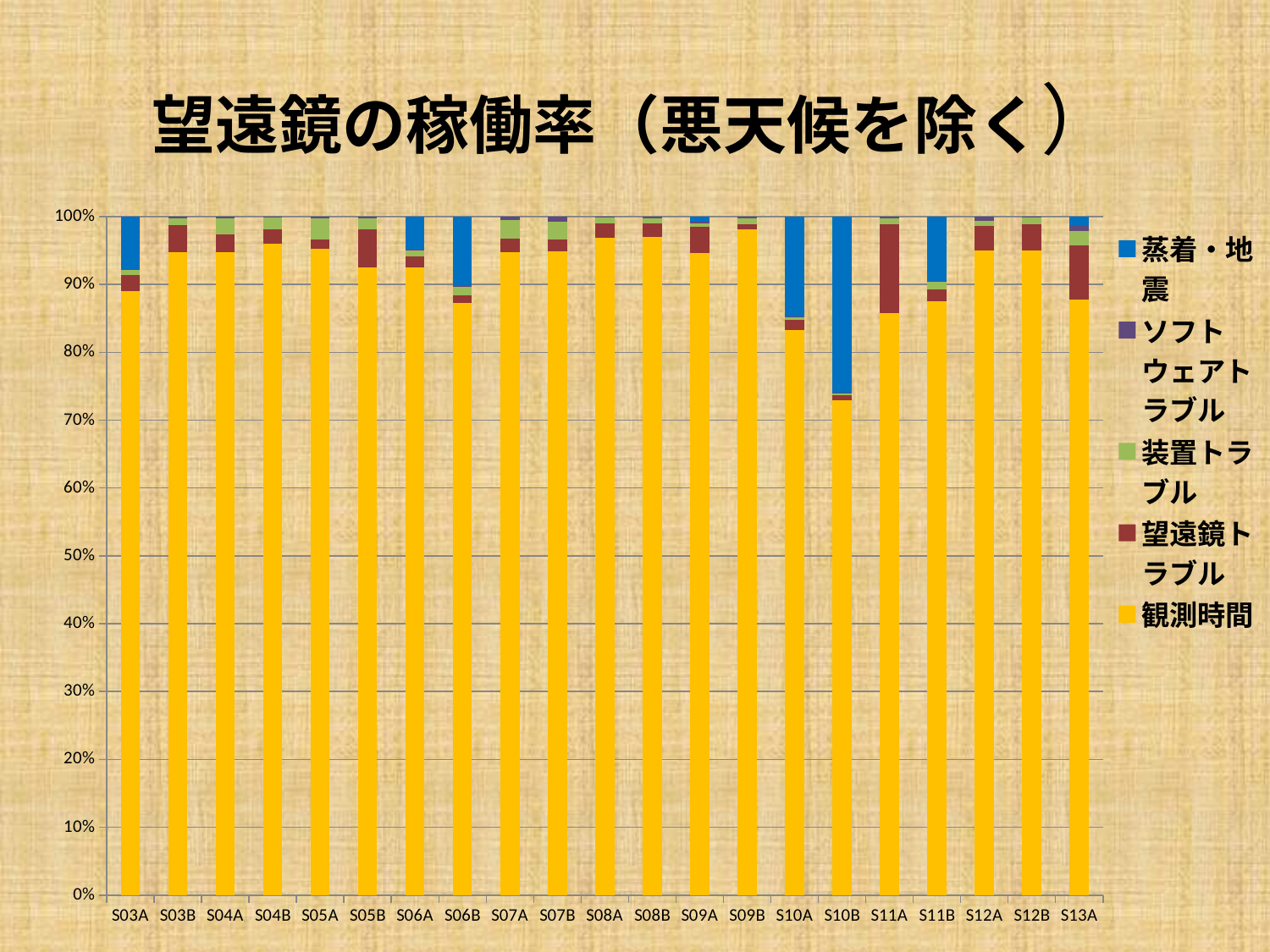
How many categories are shown along the x axis? 21 How many series does the legend list? 5 What kind of chart is shown on the slide? stacked bar chart Is the value for 観測時間 in S10B greater or less than 80%? less Which is larger, the 観測時間 value for S03B or for S11A? S03B Which is larger, the 観測時間 value for S10A or for S10B? S10A Is the value for 観測時間 in S11A greater or less than 90%? less Is the value for 観測時間 in S10A greater or less than 90%? less Which colour represents 観測時間 in the legend? yellow Which category has the lowest value for 観測時間? S10B What is the title of the chart? 望遠鏡の稼働率（悪天候を除く）